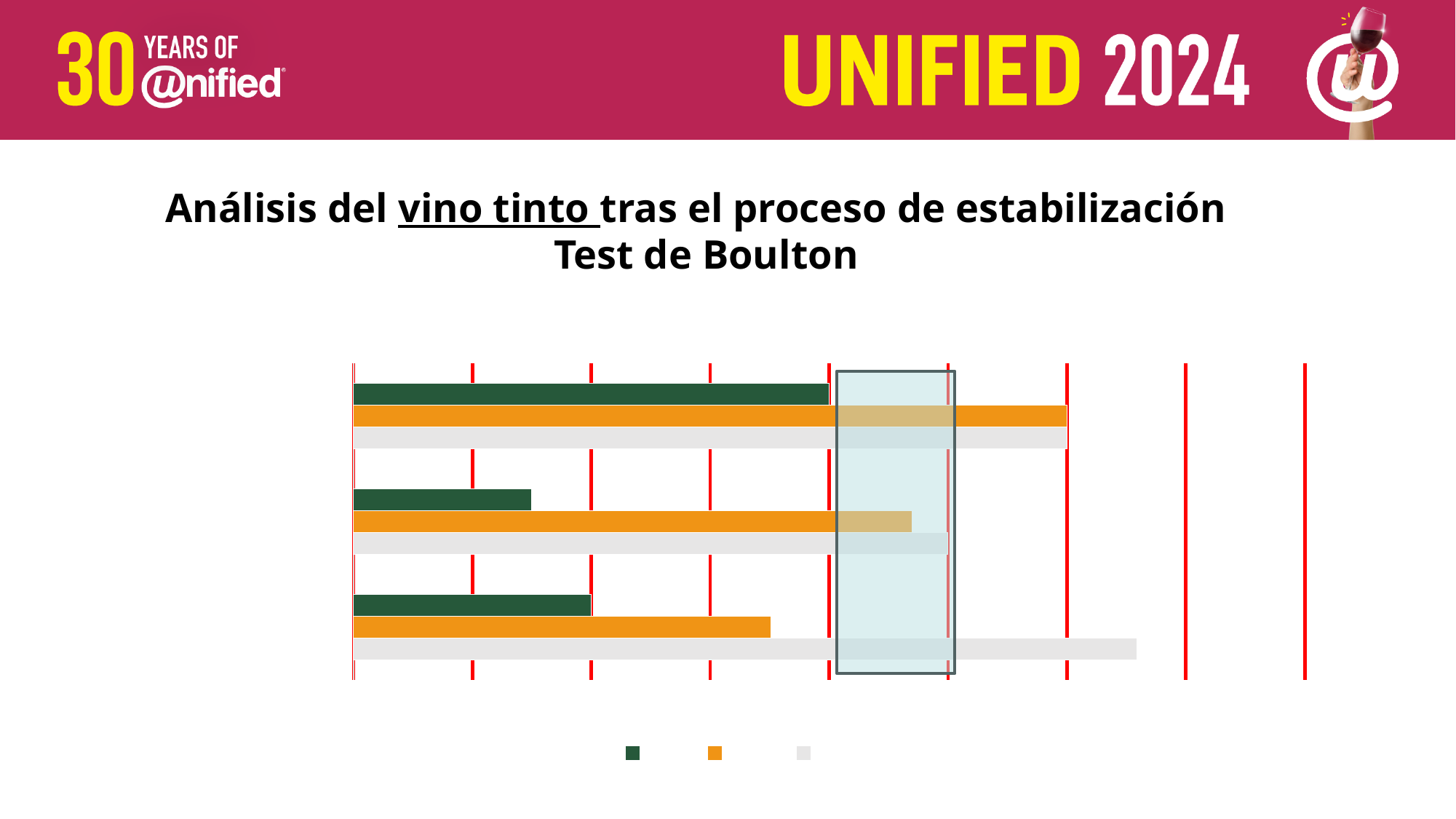
Which group of bars (top, middle or bottom) has the longest green bar? top Which group of bars (top, middle or bottom) has the shortest orange bar? bottom How many entries does the chart's legend show? 3 What three colours are used for the bars in the chart? dark green, orange and light grey What kind of chart is shown on the slide? bar chart How many groups of bars are plotted in the chart? 3 In the top group of bars, which bar is longer, the green one or the orange one? the orange one Which group of bars (top, middle or bottom) has the shortest green bar? middle In the bottom group of bars, which bar is longer, the green one or the grey one? the grey one In the middle group of bars, which bar is longer, the green one or the orange one? the orange one Which group of bars (top, middle or bottom) has the longest orange bar? top What test is named in the slide title above the chart? Test de Boulton